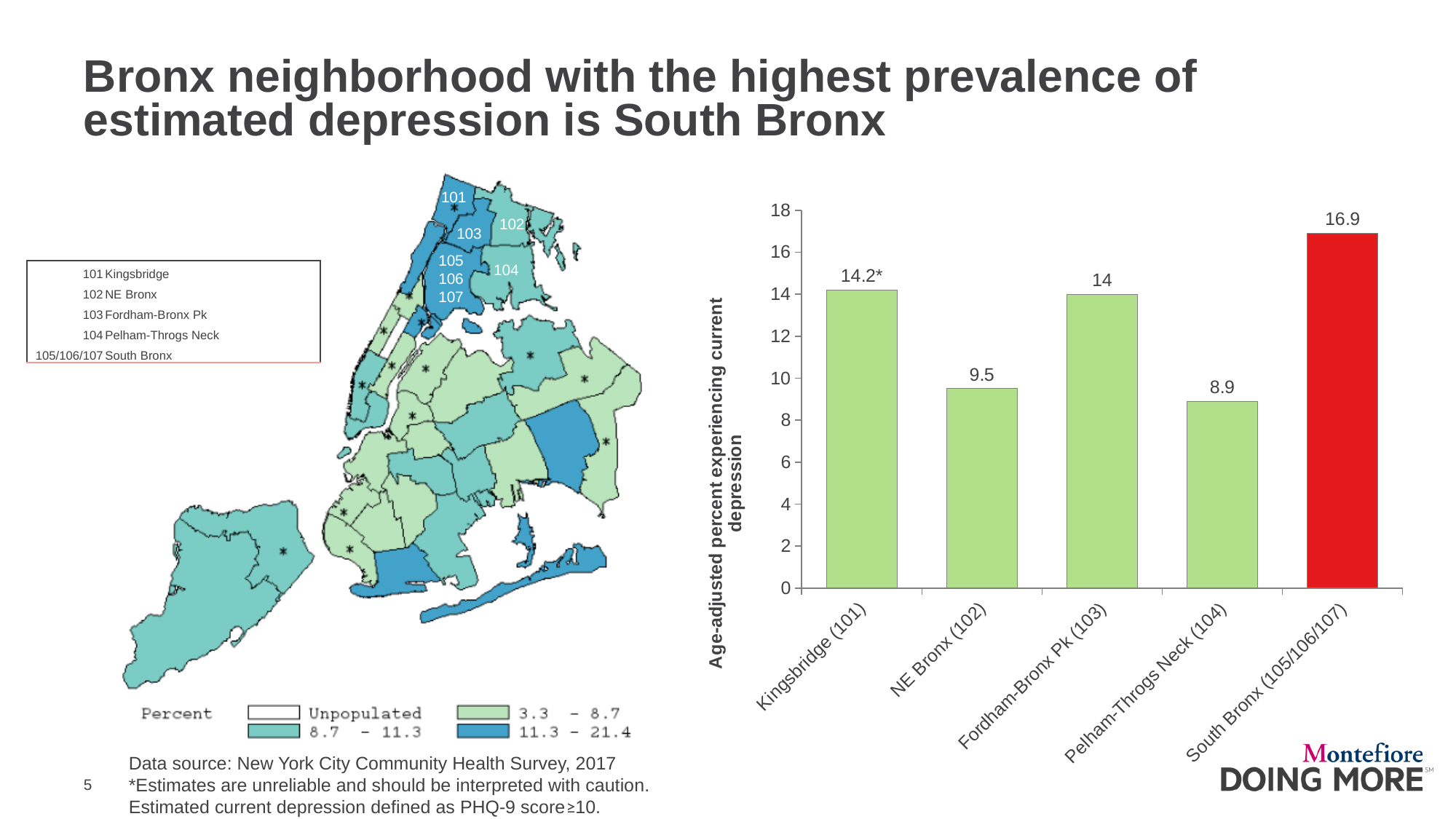
What is the value shown for Pelham-Throgs Neck (104) in the bar chart? 8.9 Which neighborhood has the highest age-adjusted percent experiencing current depression in the bar chart? South Bronx (105/106/107) What is the difference between the values for South Bronx (105/106/107) and Pelham-Throgs Neck (104)? 8 How many neighborhoods are shown in the bar chart? 5 Which bar in the bar chart is colored red rather than green? South Bronx (105/106/107) Which neighborhood has the lowest value in the bar chart? Pelham-Throgs Neck (104) What type of chart is shown on the right side of the slide? Bar chart Which has a larger value in the bar chart, NE Bronx (102) or Fordham-Bronx Pk (103)? Fordham-Bronx Pk (103) What is the data label shown for Kingsbridge (101) in the bar chart? 14.2* What is the age-adjusted percent experiencing current depression for South Bronx (105/106/107)? 16.9 What is the value shown for NE Bronx (102) in the bar chart? 9.5 What is the value shown for Fordham-Bronx Pk (103) in the bar chart? 14